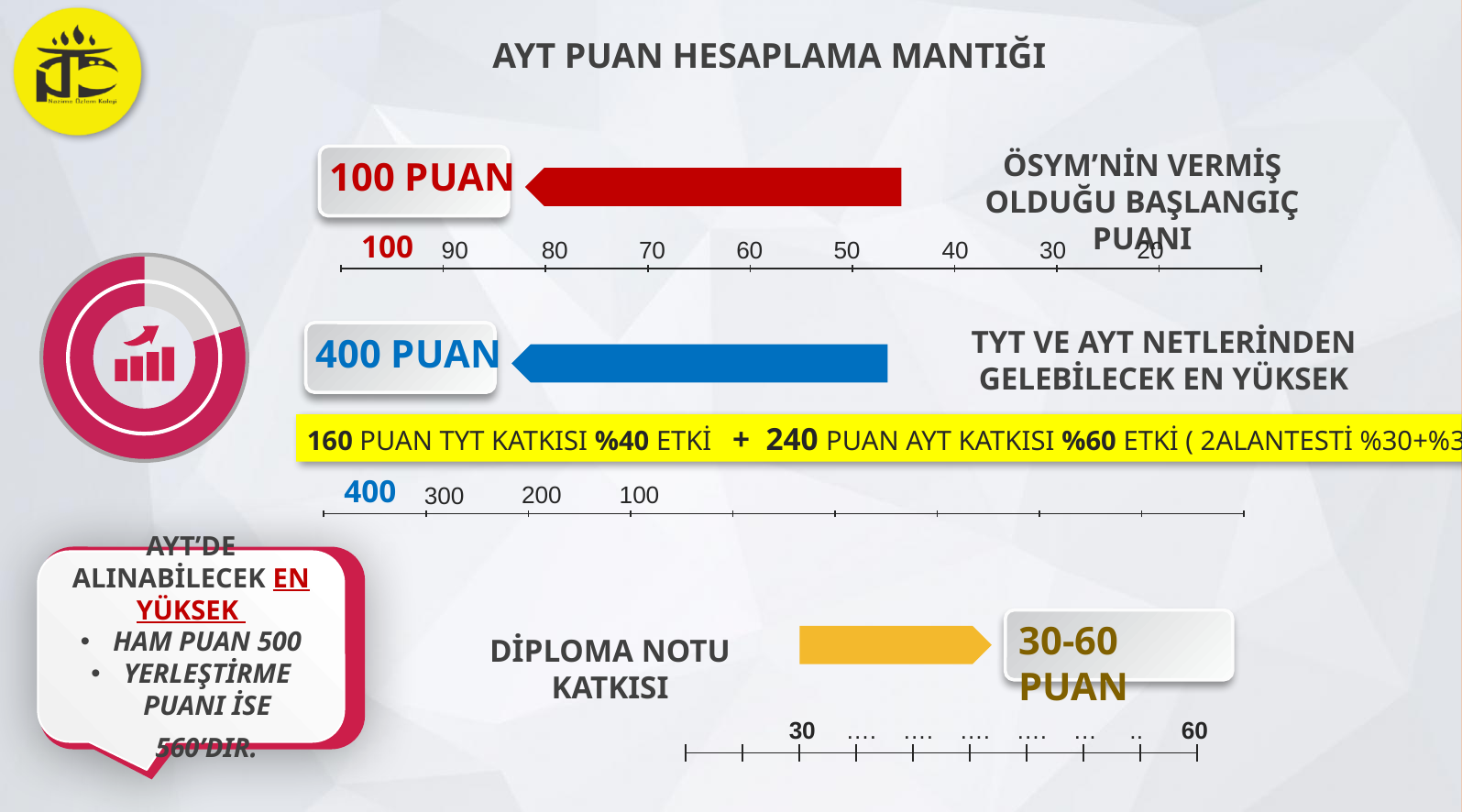
According to the yellow band under the 400 PUAN arrow, how many points does the AYT contribution (AYT katkısı) provide? 240 What percentage effect (etki) is shown for the AYT contribution? %60 What is the total of the TYT contribution (160) and the AYT contribution (240)? 400 What is the difference in points between the AYT contribution (240) and the TYT contribution (160)? 80 What percentage effect (etki) is shown for the TYT contribution? %40 In the middle arrow diagram, what is the highest score that can come from TYT and AYT nets? 400 PUAN Which contributes more points, the TYT contribution or the AYT contribution? AYT contribution According to the yellow band under the 400 PUAN arrow, how many points does the TYT contribution (TYT katkısı) provide? 160 In the top arrow diagram, what is the starting score given by ÖSYM (ÖSYM'nin vermiş olduğu başlangıç puanı)? 100 PUAN What is the highest value labelled on the scale under the red 100 PUAN arrow? 100 In the bottom arrow diagram, what is the score range for the diploma grade contribution (Diploma Notu Katkısı)? 30-60 PUAN What colour is the arrow for the 400 PUAN score? Blue